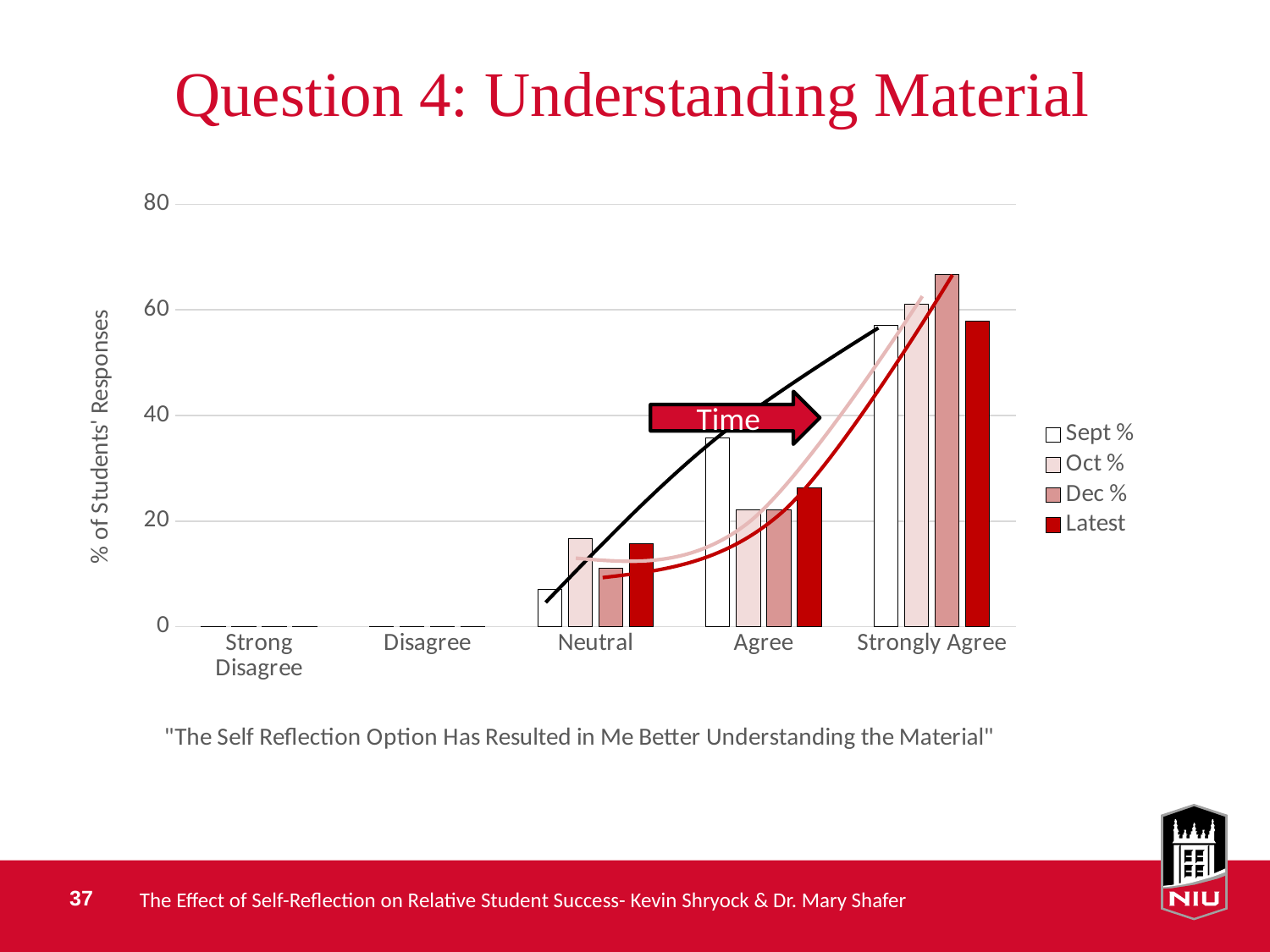
Is the Dec % value for Strongly Agree greater or less than 60? greater What is the label on the vertical axis? % of Students' Responses For the Latest series, which category has the highest value? Strongly Agree Is the Sept % value for Neutral greater or less than 20? less For the Agree category, which is larger: the Sept % value or the Oct % value? Sept % How many series does the legend list? 4 Is the Sept % value for Agree greater or less than 20? greater For the Sept % series, which category has the highest value? Strongly Agree For the Strongly Agree category, which is larger: the Dec % value or the Sept % value? Dec % How many response categories are shown on the x axis? 5 Which series are listed in the legend? Sept %, Oct %, Dec %, Latest What kind of chart is shown on the slide? Bar chart